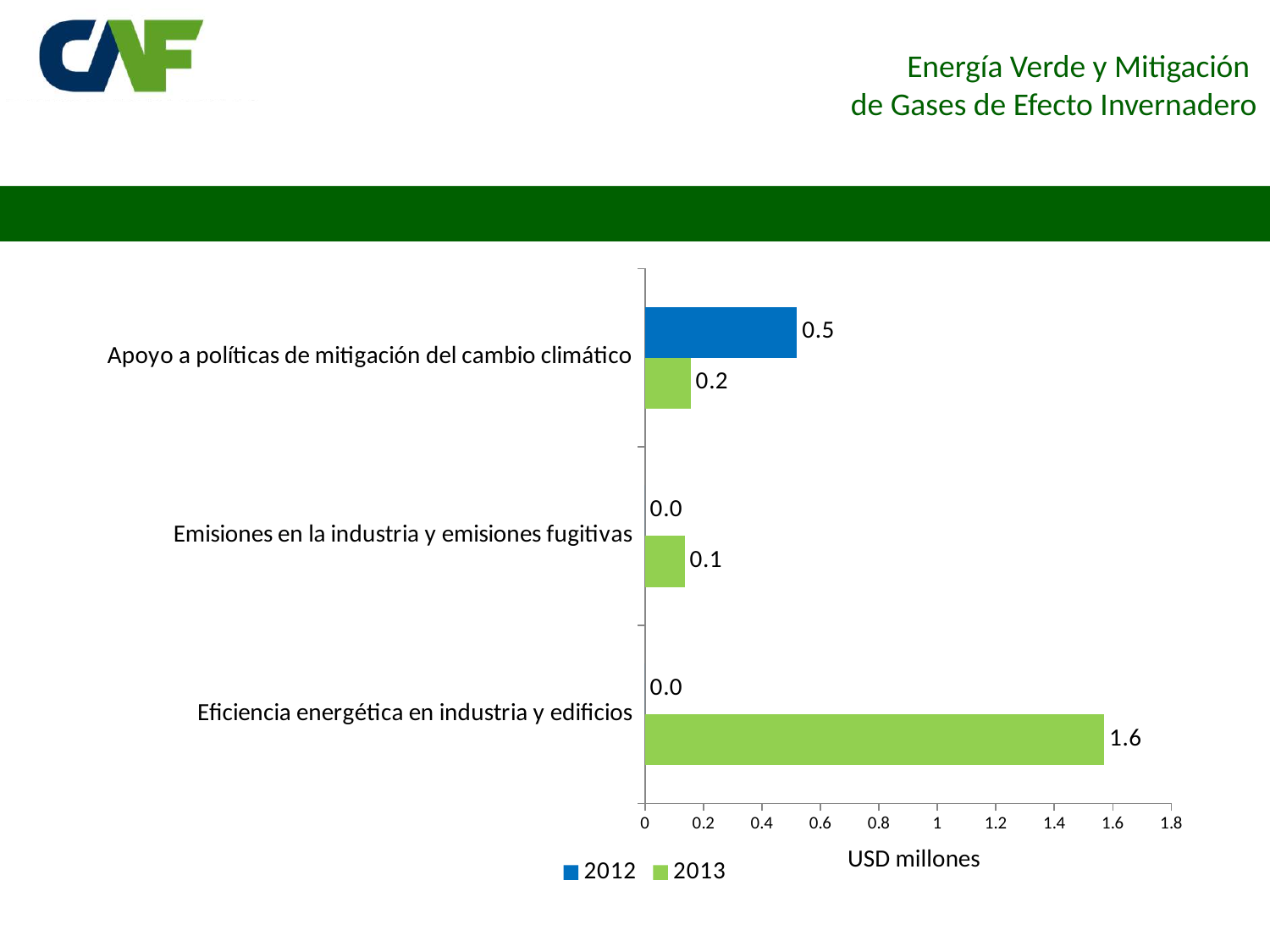
For Apoyo a políticas de mitigación del cambio climático, which year has the larger value, 2012 or 2013? 2012 What kind of chart is shown on the slide? Bar chart Which category has the highest 2013 value? Eficiencia energética en industria y edificios Which category has the lowest 2013 value? Emisiones en la industria y emisiones fugitivas What is the 2012 value for Apoyo a políticas de mitigación del cambio climático? 0.5 What is the 2012 value for Eficiencia energética en industria y edificios? 0.0 How many categories are shown on the chart? 3 How many series does the legend list? 2 What is the difference between the 2012 and 2013 values for Apoyo a políticas de mitigación del cambio climático? 0.3 What is the 2013 value for Eficiencia energética en industria y edificios? 1.6 What is the 2013 value for Emisiones en la industria y emisiones fugitivas? 0.1 What unit is shown on the x axis of the chart? USD millones